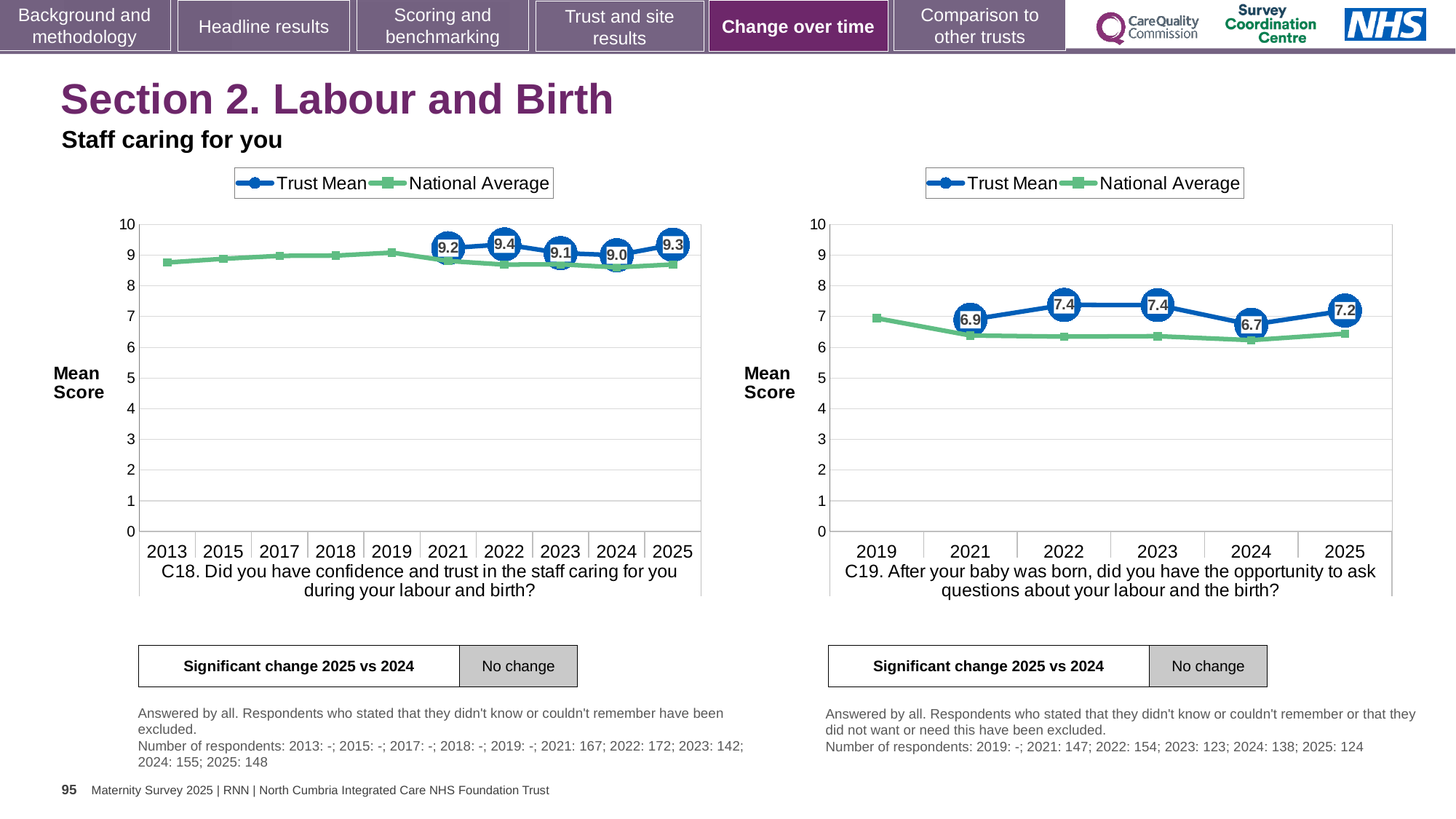
In the C18 chart (left), what is the Trust Mean for 2022? 9.4 In the C19 chart (right), what is the Trust Mean for 2021? 6.9 In the C19 chart (right), which year has the lowest labelled Trust Mean? 2024 In the C18 chart (left), what is the Trust Mean for 2025? 9.3 In the C19 chart (right), is the Trust Mean for 2025 larger or smaller than the Trust Mean for 2024? larger In the C19 chart (right), what is the Trust Mean for 2024? 6.7 In the C19 chart (right), is the National Average for 2024 greater or less than 7? less In the C18 chart (left), which year has the lowest labelled Trust Mean? 2024 In the C18 chart (left), how many years are shown on the x axis? 10 How many series does the legend of the C19 chart (right) list? 2 What kind of chart is the C18 chart (left)? line chart In the C18 chart (left), what is the difference between the Trust Mean in 2022 and in 2024? 0.4